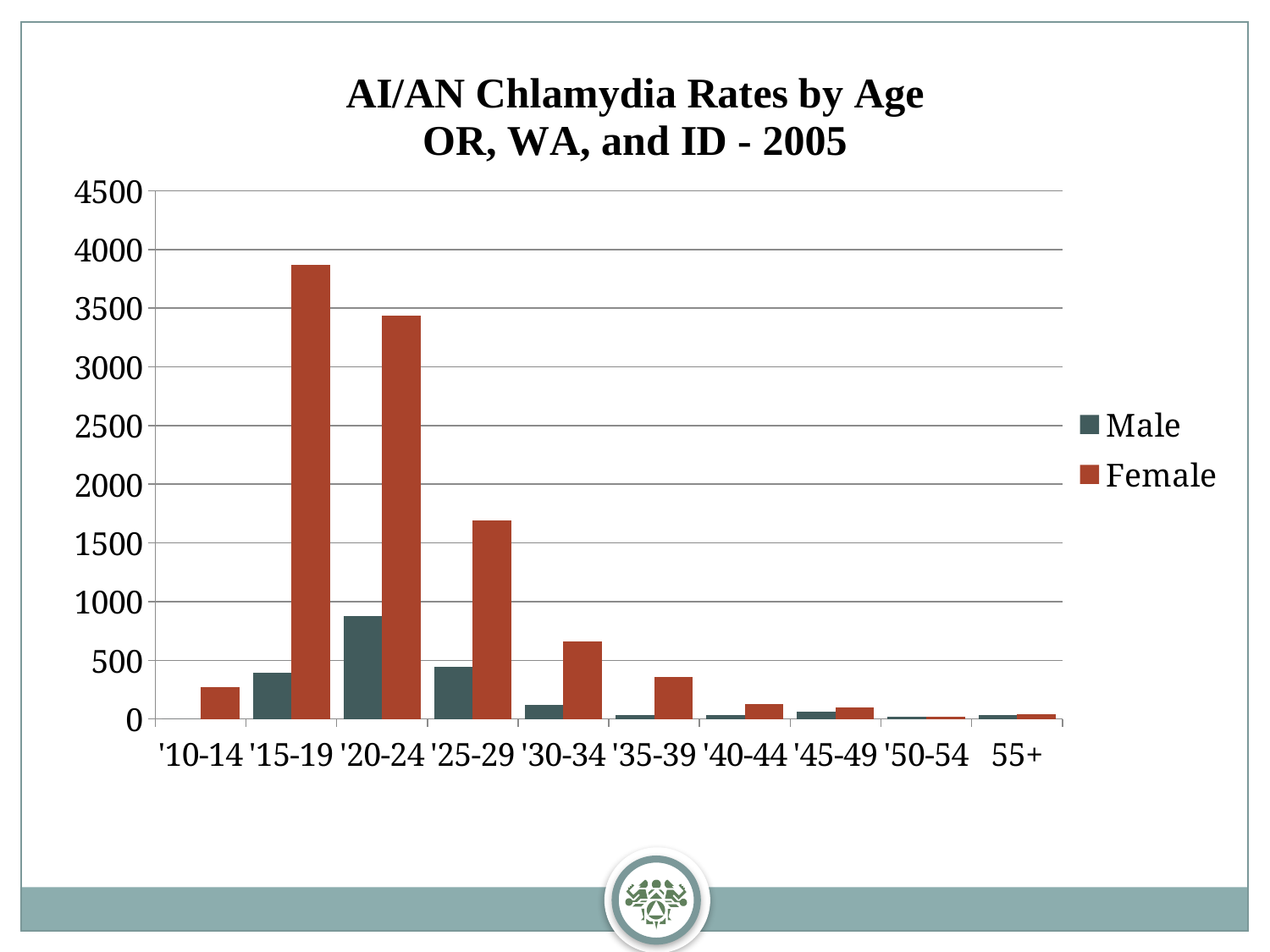
Is the Female rate for '15-19 greater or less than 3500? greater From the '15-19 age group onward, do the Female rates rise or fall as age increases? fall Which is larger, the Female rate for '15-19 or the Female rate for '20-24? '15-19 Which age group has the highest Male chlamydia rate? '20-24 What kind of chart is shown on the slide? bar chart For the '25-29 age group, which series has the larger value, Male or Female? Female How many age groups are shown on the x axis? 10 Is the Female rate for '25-29 greater or less than 1500? greater Is the Male rate for '20-24 greater or less than 1000? less How many series does the legend list? 2 Which age group has the highest Female chlamydia rate? '15-19 What colour represents the Female series in the legend? red